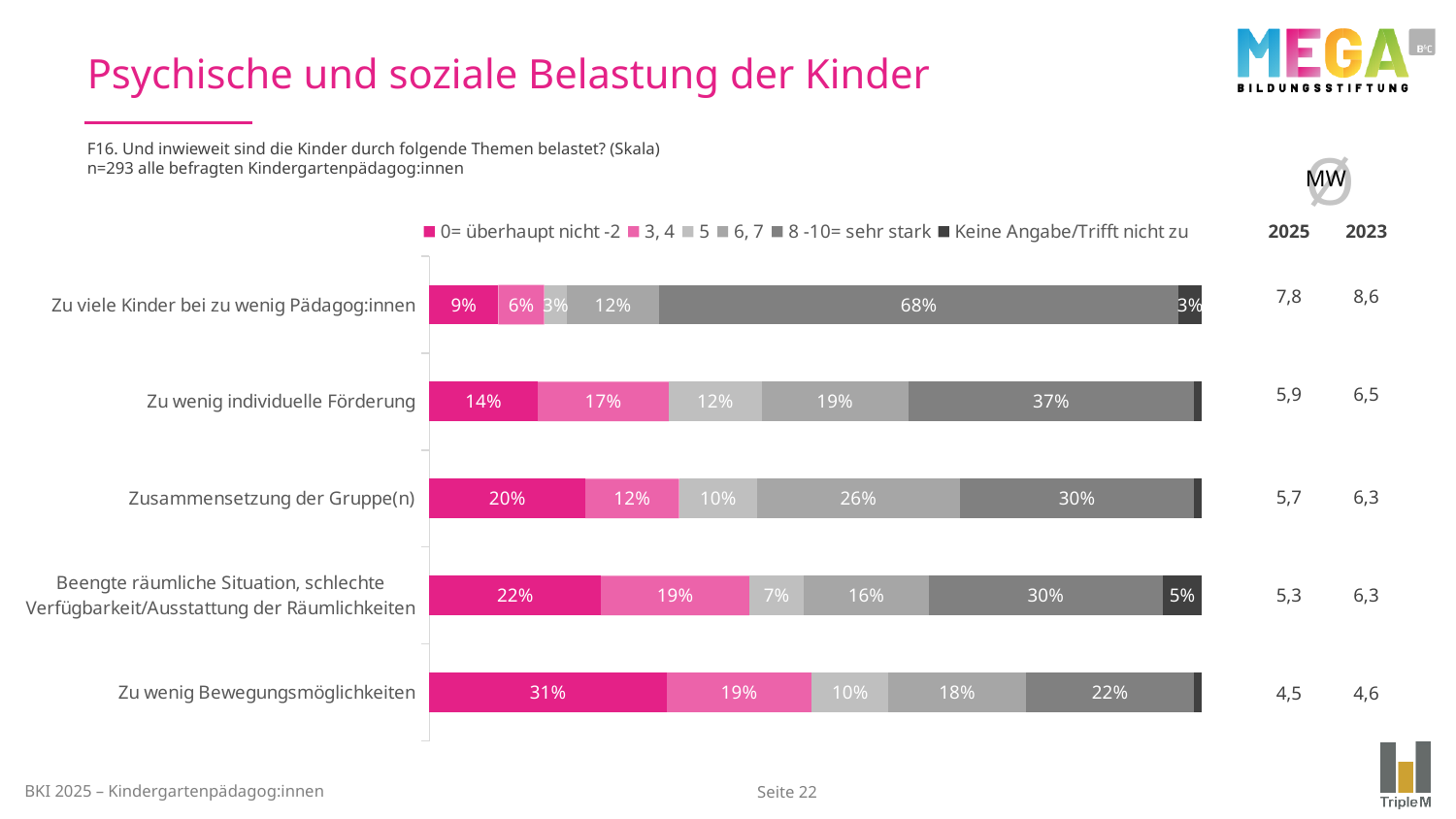
How many categories (topics) are plotted in the chart? 5 Which category has the lowest value for the "0= überhaupt nicht -2" series? Zu viele Kinder bei zu wenig Pädagog:innen What is the 2025 mean value (MW) shown for "Zu wenig individuelle Förderung"? 5,9 What is the value of the "8 -10= sehr stark" segment for "Zu viele Kinder bei zu wenig Pädagog:innen"? 68% What kind of chart is shown on the slide? stacked bar chart What is the value of the "6, 7" segment for "Zusammensetzung der Gruppe(n)"? 26% What is the title of the chart slide? Psychische und soziale Belastung der Kinder What is the value of the "0= überhaupt nicht -2" segment for "Zu wenig Bewegungsmöglichkeiten"? 31% Which is larger: the "3, 4" value for "Beengte räumliche Situation, schlechte Verfügbarkeit/Ausstattung der Räumlichkeiten" or the "3, 4" value for "Zusammensetzung der Gruppe(n)"? Beengte räumliche Situation, schlechte Verfügbarkeit/Ausstattung der Räumlichkeiten How many series does the legend list? 6 Which category has the highest value for the "8 -10= sehr stark" series? Zu viele Kinder bei zu wenig Pädagog:innen What is the difference between the "8 -10= sehr stark" values for "Zu wenig individuelle Förderung" and "Zu wenig Bewegungsmöglichkeiten"? 15%